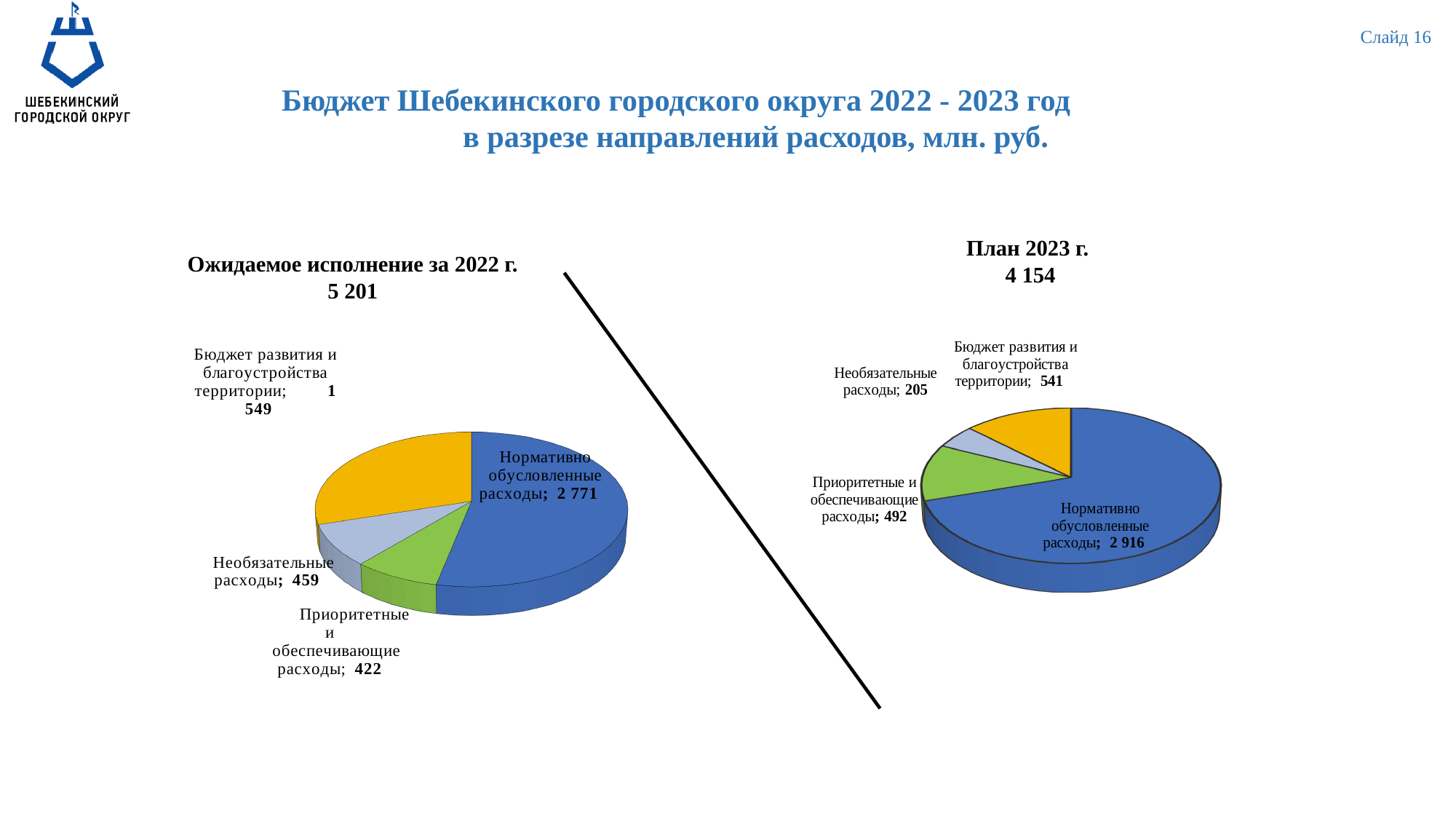
What is the difference between 'Нормативно обусловленные расходы' in the 'План 2023 г.' chart and in the 'Ожидаемое исполнение за 2022 г.' chart? 145 In the 'План 2023 г.' chart, what is the value for 'Необязательные расходы'? 205 What type of chart is used on the slide for 'Ожидаемое исполнение за 2022 г.'? pie chart How many categories does the 'План 2023 г.' pie chart show? 4 In the 'Ожидаемое исполнение за 2022 г.' chart, which category has the smallest value? Приоритетные и обеспечивающие расходы In the 'План 2023 г.' chart, which category has the smallest value? Необязательные расходы In the 'Ожидаемое исполнение за 2022 г.' chart, which is larger: 'Необязательные расходы' or 'Приоритетные и обеспечивающие расходы'? Необязательные расходы In the 'Ожидаемое исполнение за 2022 г.' chart, what is the value for 'Нормативно обусловленные расходы'? 2 771 What total is shown under the title 'Ожидаемое исполнение за 2022 г.'? 5 201 In the 'План 2023 г.' chart, what is the value for 'Приоритетные и обеспечивающие расходы'? 492 In the 'План 2023 г.' chart, which category has the largest value? Нормативно обусловленные расходы In the 'Ожидаемое исполнение за 2022 г.' chart, what is the value for 'Бюджет развития и благоустройства территории'? 1 549